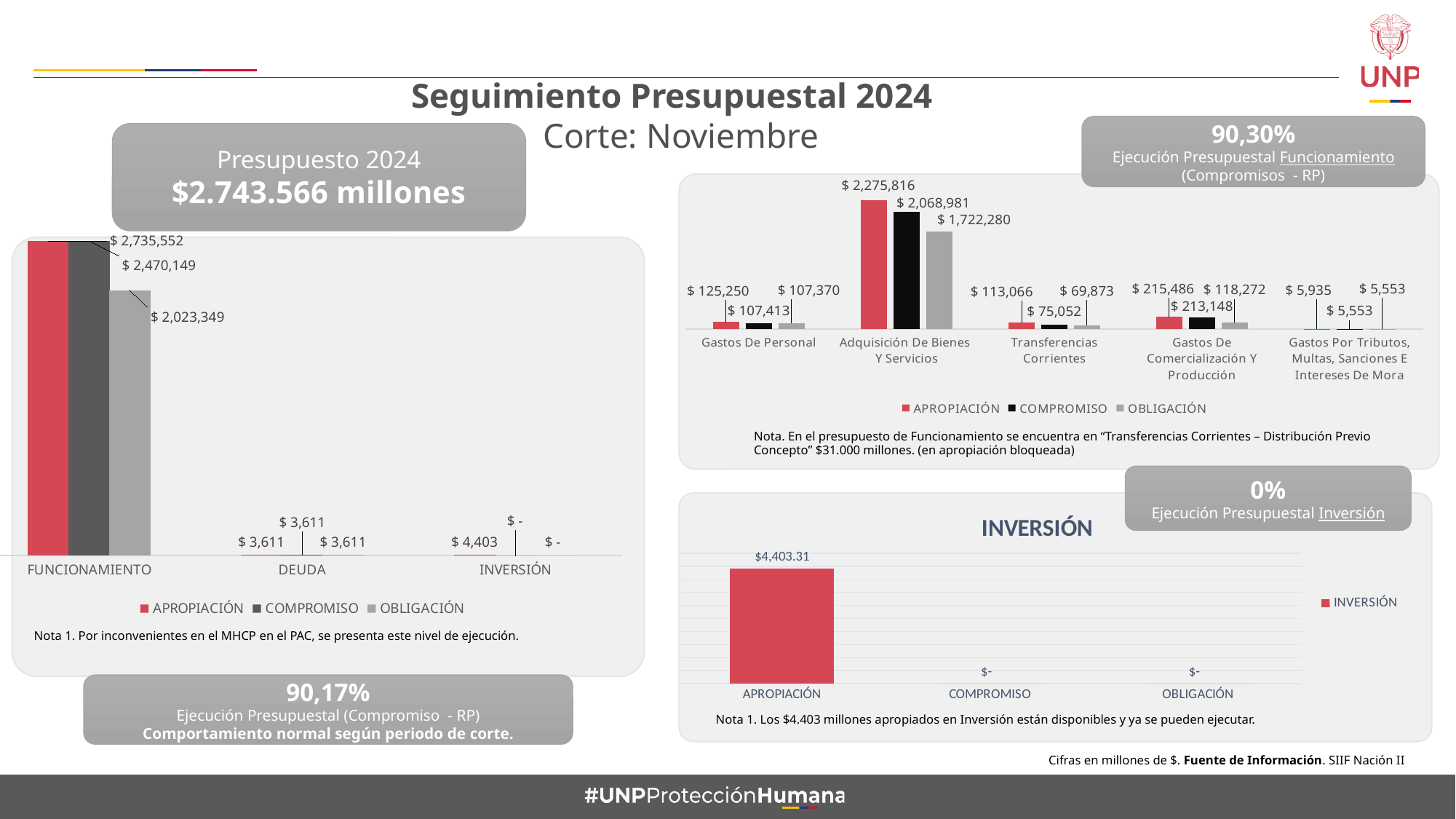
In the top-right chart, which category has the highest APROPIACIÓN value? Adquisición De Bienes Y Servicios In the top-right chart, what is the OBLIGACIÓN value for Adquisición De Bienes Y Servicios? $ 1,722,280 In the chart on the left of the slide, what is the difference between the APROPIACIÓN and OBLIGACIÓN values for FUNCIONAMIENTO? $ 712,203 How many categories are shown on the x axis of the top-right chart? 5 In the chart on the left of the slide, what is the APROPIACIÓN value for DEUDA? $ 3,611 In the top-right chart, which has the larger APROPIACIÓN value: Transferencias Corrientes or Gastos De Comercialización Y Producción? Gastos De Comercialización Y Producción How many series does the legend of the chart on the left of the slide list? 3 What kind of chart is the bottom-right chart titled INVERSIÓN? Bar chart In the chart on the left of the slide, what is the COMPROMISO value for FUNCIONAMIENTO? $ 2,470,149 In the top-right chart, which category has the lowest APROPIACIÓN value? Gastos Por Tributos, Multas, Sanciones E Intereses De Mora In the bottom-right chart titled INVERSIÓN, what is the value for APROPIACIÓN? $4,403.31 In the top-right chart, what is the difference between the APROPIACIÓN and COMPROMISO values for Gastos De Personal? $ 17,837